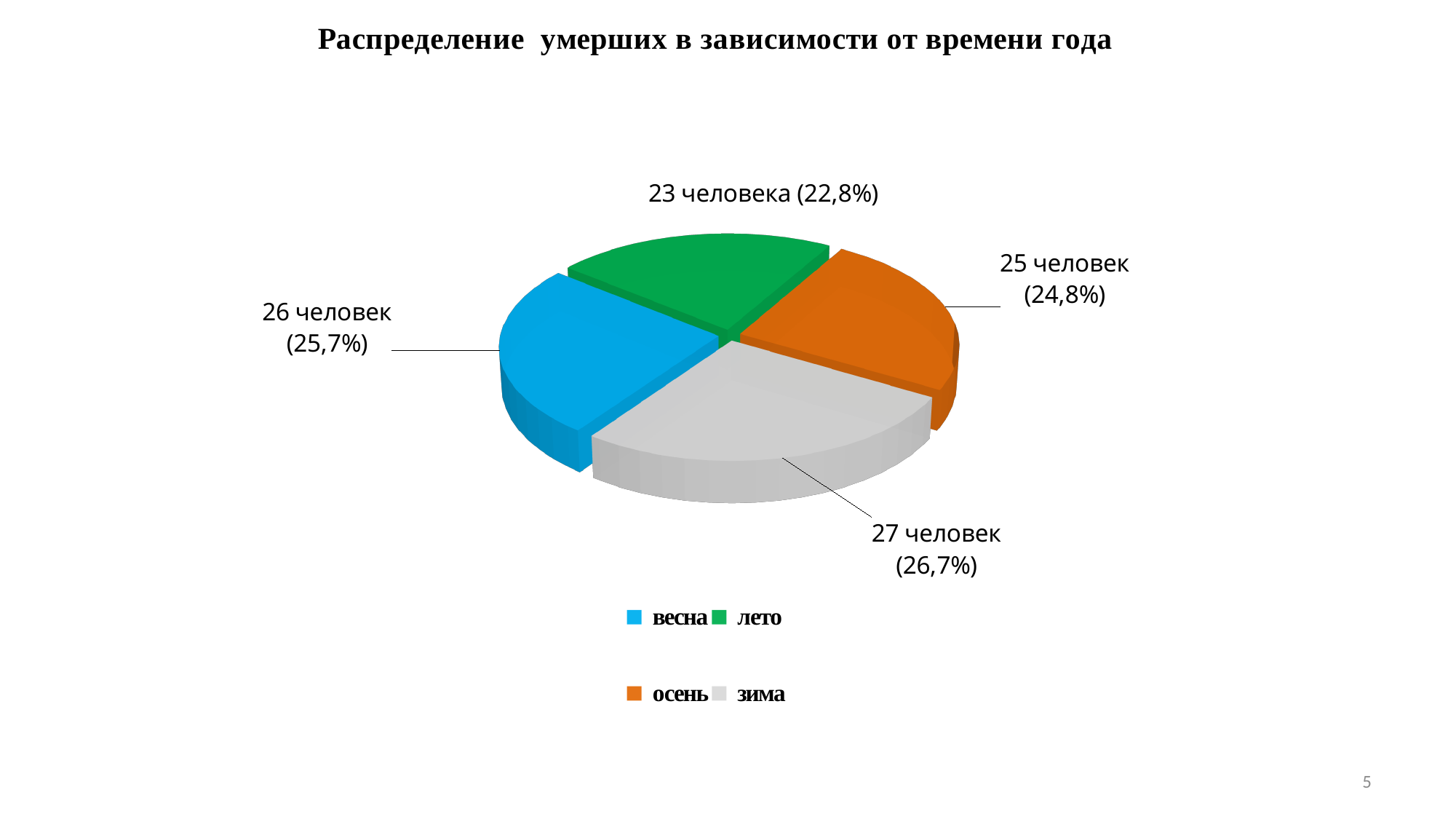
What percentage share is shown for the лето slice? 22,8% Which season has the largest slice of the pie? зима What kind of chart is shown on the slide? pie chart What is the title of the chart? Распределение умерших в зависимости от времени года How many slices does the pie chart have? 4 What is the difference in the number of people between зима and лето? 4 Which slice is larger, весна or осень? весна How many people does the осень slice represent? 25 человек What percentage share is shown for the зима slice? 26,7% How many people does the весна slice represent? 26 человек Which season has the smallest slice of the pie? лето What is the total number of people across all four slices? 101